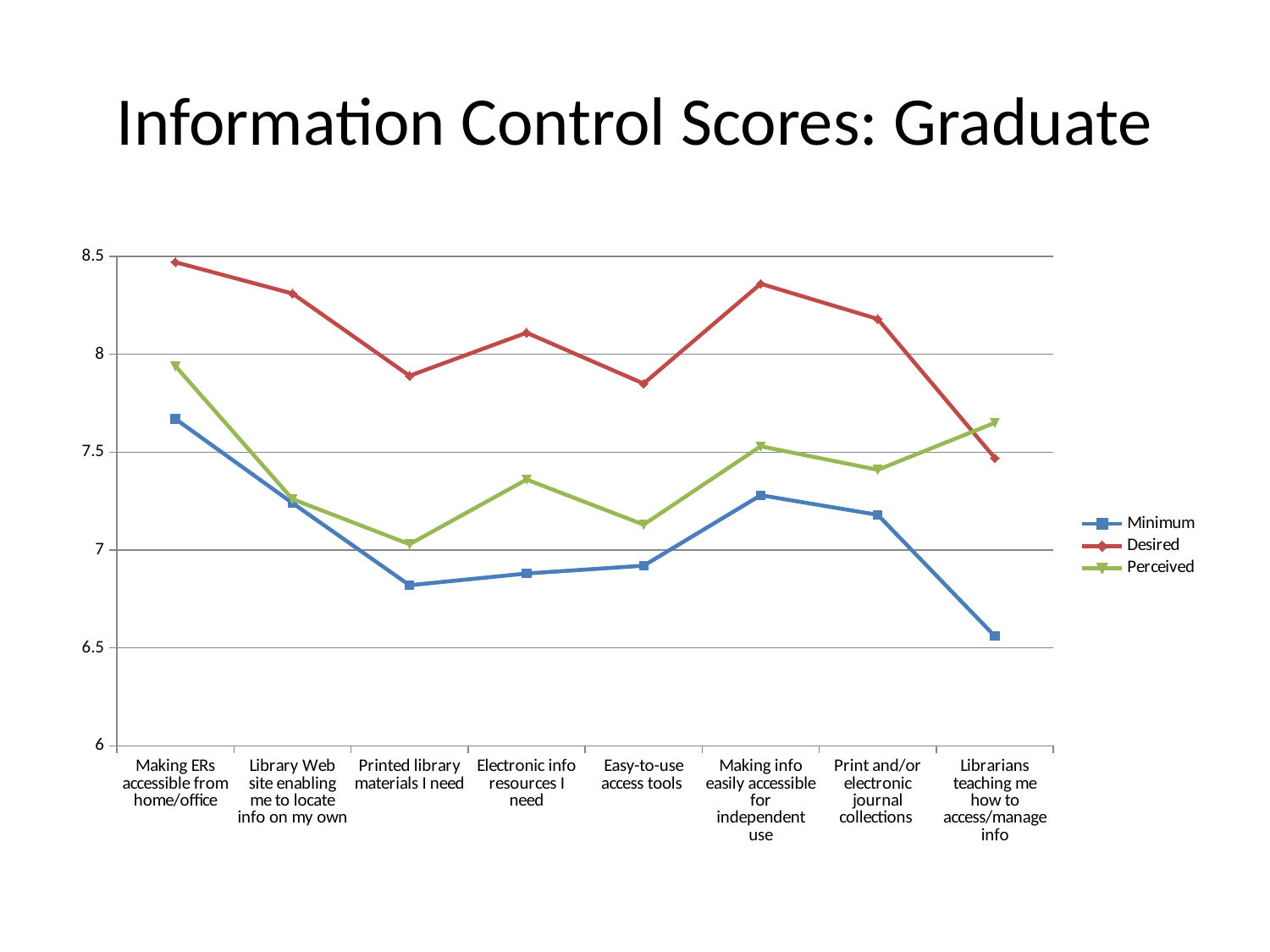
For which category is the Desired series lowest? Librarians teaching me how to access/manage info How many categories are plotted along the x axis? 8 Does the Minimum series rise or fall from Print and/or electronic journal collections to Librarians teaching me how to access/manage info? Fall How many series does the legend list? 3 Is the Minimum value for Librarians teaching me how to access/manage info greater or less than 7? less Which series is drawn in red? Desired Is the Desired value for Easy-to-use access tools greater or less than 8? less For which category is the Minimum series lowest? Librarians teaching me how to access/manage info For which category is the Minimum series highest? Making ERs accessible from home/office What kind of chart is shown on the slide? Line chart What is the title of the chart? Information Control Scores: Graduate For Librarians teaching me how to access/manage info, which is larger: the Desired value or the Perceived value? Perceived